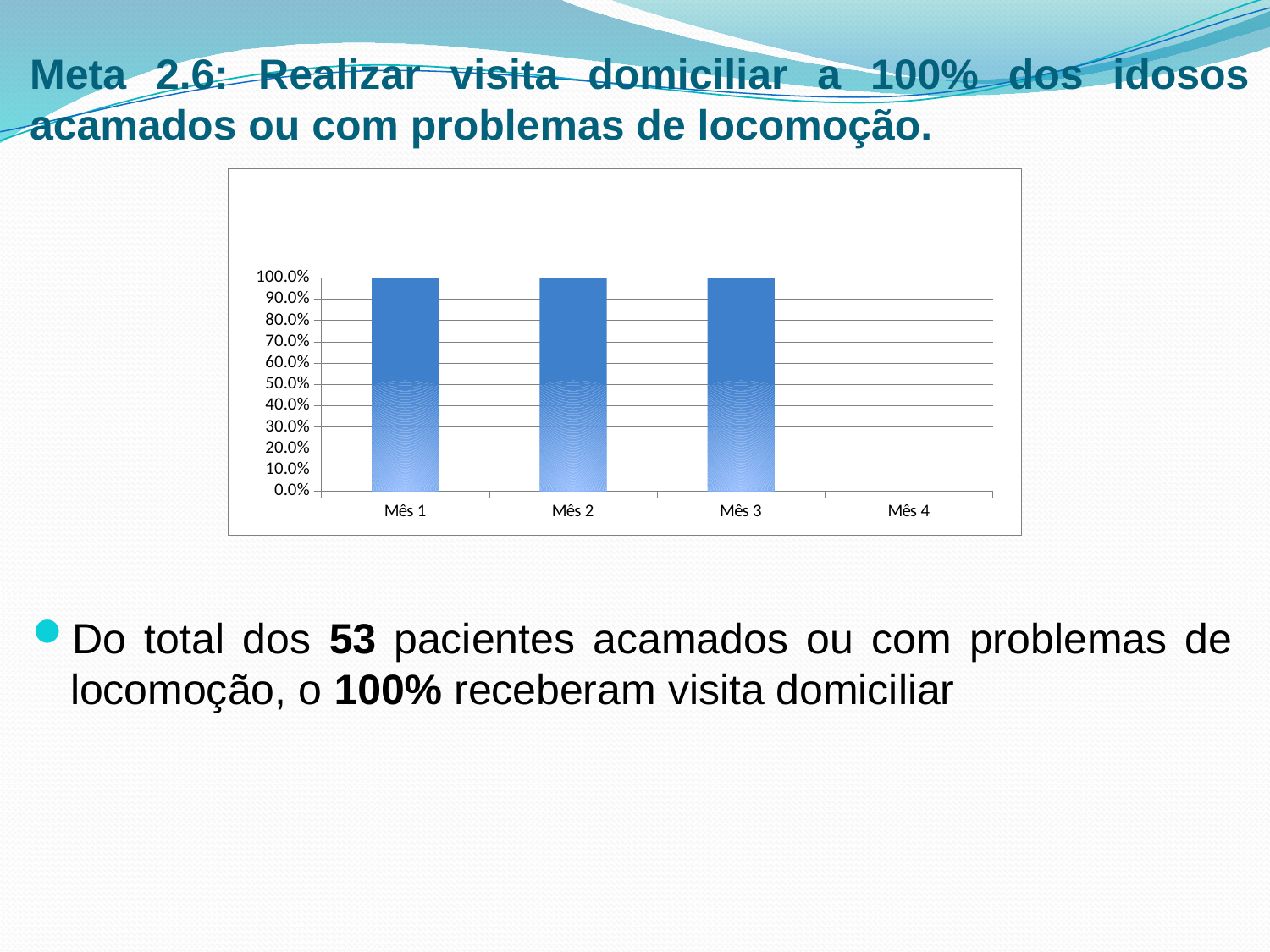
What is the difference between the values for Mês 1 and Mês 3 in the chart? 0.0% How many categories are shown on the x axis of the chart? 4 What is the value for Mês 3 in the chart? 100.0% What is the highest tick label shown on the y axis of the chart? 100.0% Which category has the lowest value in the chart? Mês 4 What is the value for Mês 2 in the chart? 100.0% What is the value for Mês 1 in the chart? 100.0% Is the value for Mês 3 greater or less than 50.0%? greater What is the label of the first category on the x axis of the chart? Mês 1 Which is larger in the chart, the value for Mês 1 or the value for Mês 4? Mês 1 What kind of chart is shown on the slide? bar chart Is the value for Mês 2 greater or less than 90.0%? greater